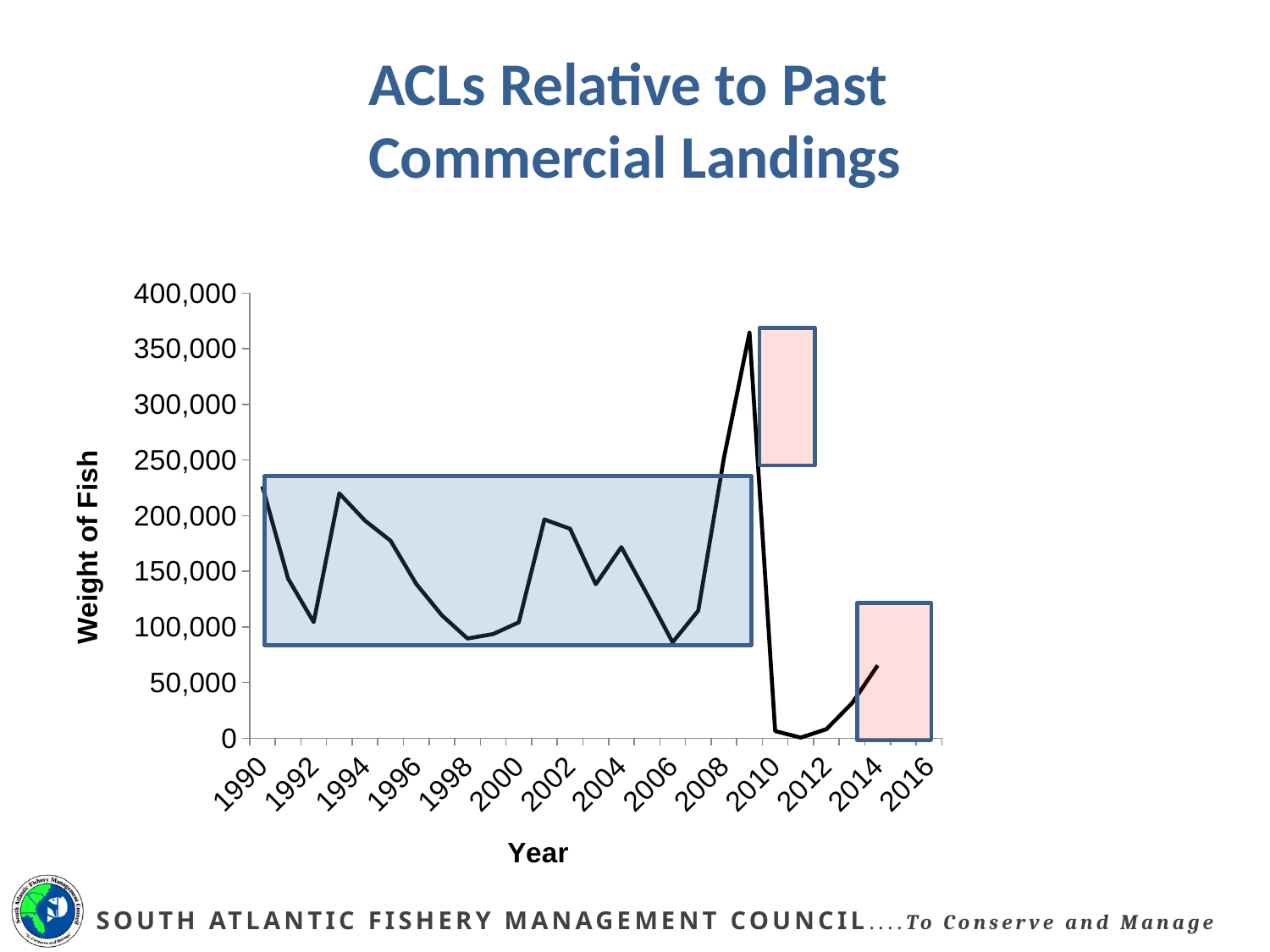
Is the value for 2006 greater or less than 100,000? less Which year has the larger value, 1990 or 2006? 1990 Is the value for 2011 greater or less than 50,000? less Is the value for 2003 greater or less than 150,000? less What is the title of the chart? ACLs Relative to Past Commercial Landings Do the values rise or fall between 2009 and 2011? fall In which year does the line reach its highest value? 2009 What is the label on the vertical axis of the chart? Weight of Fish What kind of chart is shown on the slide? line chart